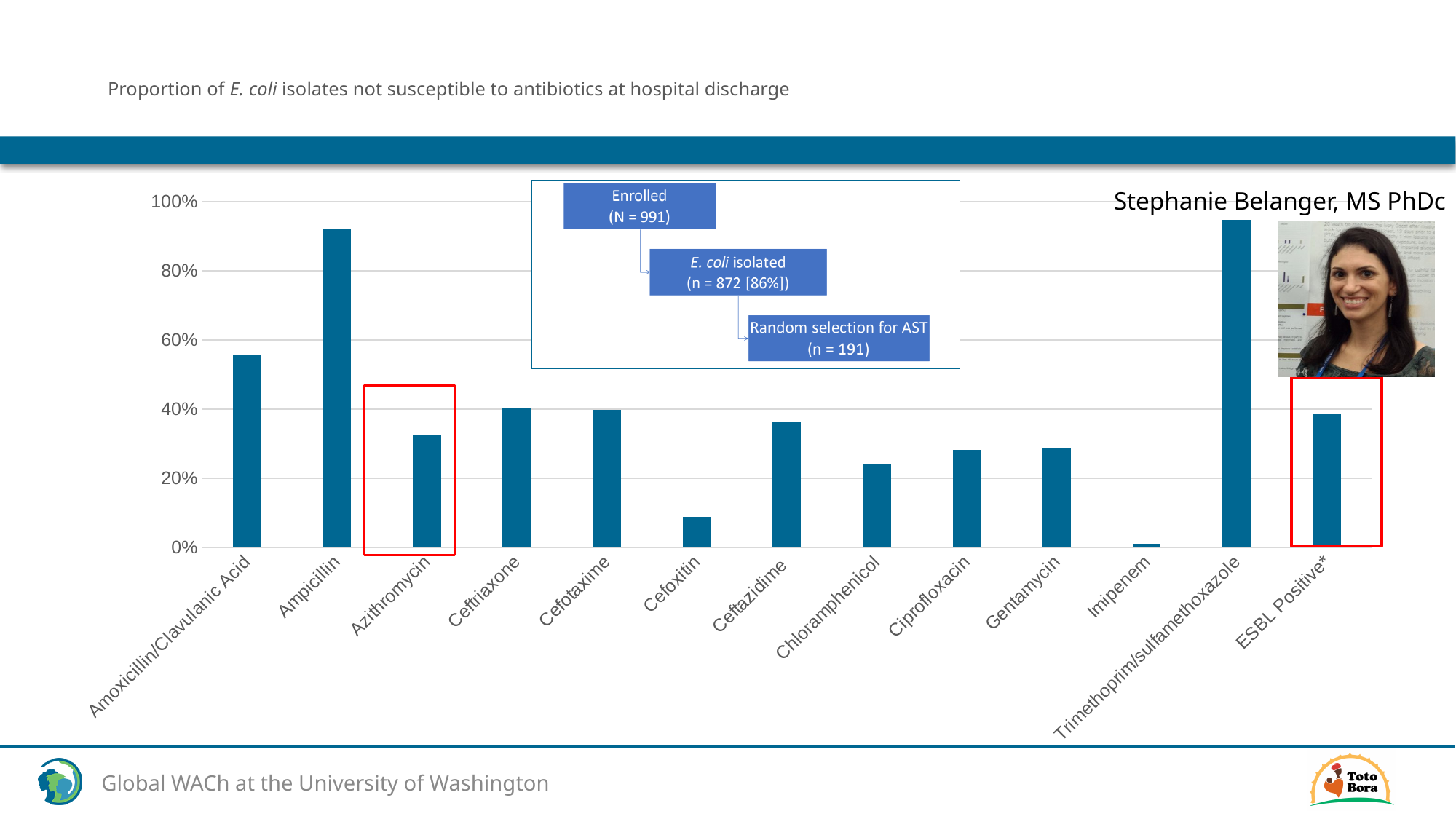
What kind of chart is shown on the slide? bar chart Which is larger, the value for Ampicillin or the value for Azithromycin? Ampicillin Is the value for Amoxicillin/Clavulanic Acid greater or less than 40%? greater Is the value for Ciprofloxacin greater or less than 40%? less Is the value for Ampicillin greater or less than 80%? greater Which is larger, the value for Cefoxitin or the value for Chloramphenicol? Chloramphenicol Which two bars are outlined with red boxes on the chart? Azithromycin and ESBL Positive* How many antibiotic categories are plotted on the x axis of the chart? 13 What is the title of the chart? Proportion of E. coli isolates not susceptible to antibiotics at hospital discharge Which category has the lowest proportion of E. coli isolates not susceptible? Imipenem